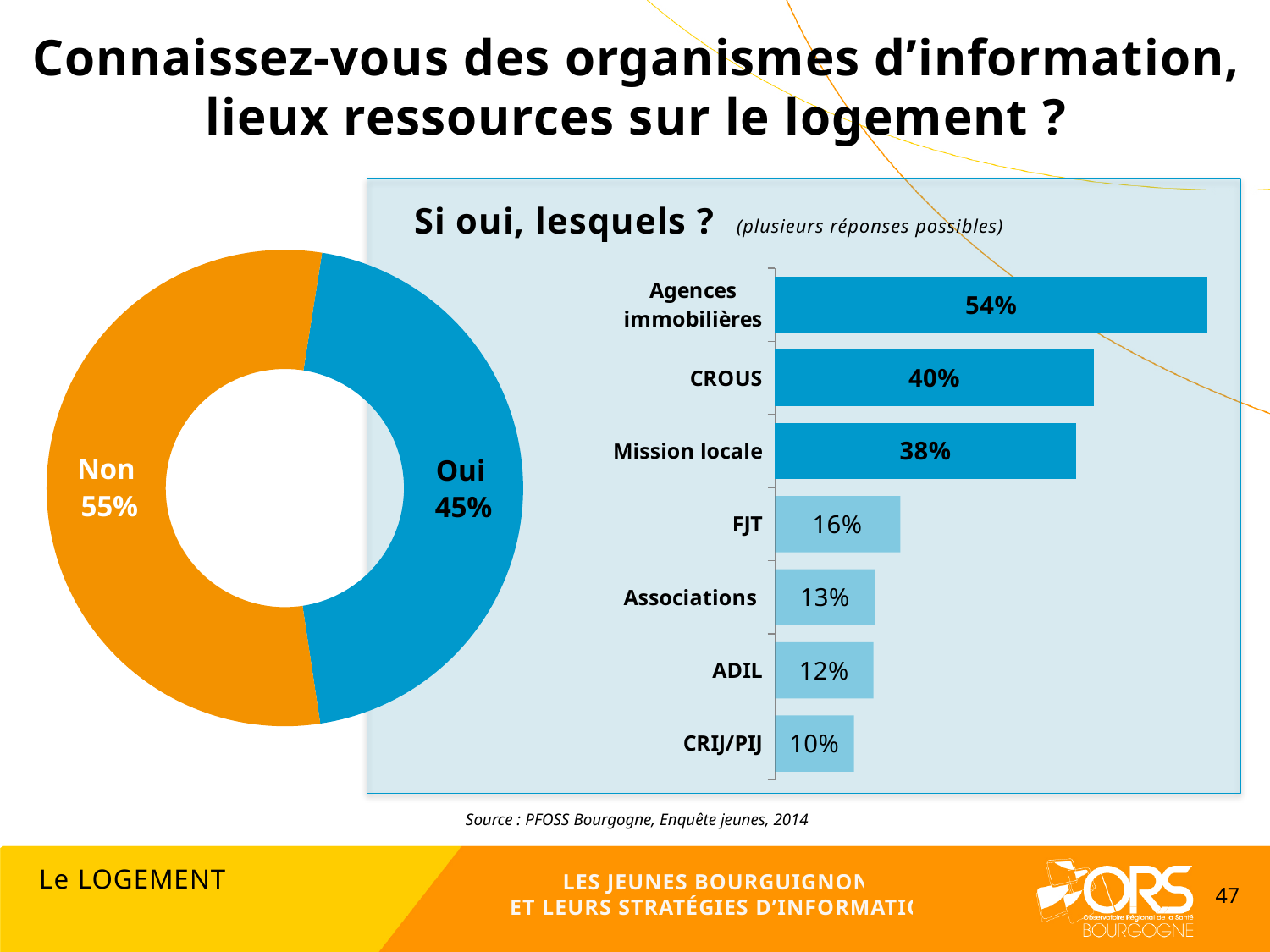
In the bar chart "Si oui, lesquels ?", what is the difference between Agences immobilières and Mission locale? 16% In the bar chart "Si oui, lesquels ?", which category has the lowest value? CRIJ/PIJ What kind of chart is the chart on the left of the slide? Doughnut chart How many categories are shown in the bar chart "Si oui, lesquels ?"? 7 In the bar chart "Si oui, lesquels ?", what is the value for ADIL? 12% In the doughnut chart on the left, what is the difference between the Non and Oui shares? 10% In the bar chart "Si oui, lesquels ?", what is the value for CROUS? 40% In the doughnut chart on the left, what share of respondents answered "Non"? 55% In the doughnut chart on the left, which answer has the larger share, Oui or Non? Non In the bar chart "Si oui, lesquels ?", which category has the highest value? Agences immobilières In the bar chart "Si oui, lesquels ?", which is larger, FJT or Associations? FJT In the doughnut chart on the left, what share of respondents answered "Oui"? 45%